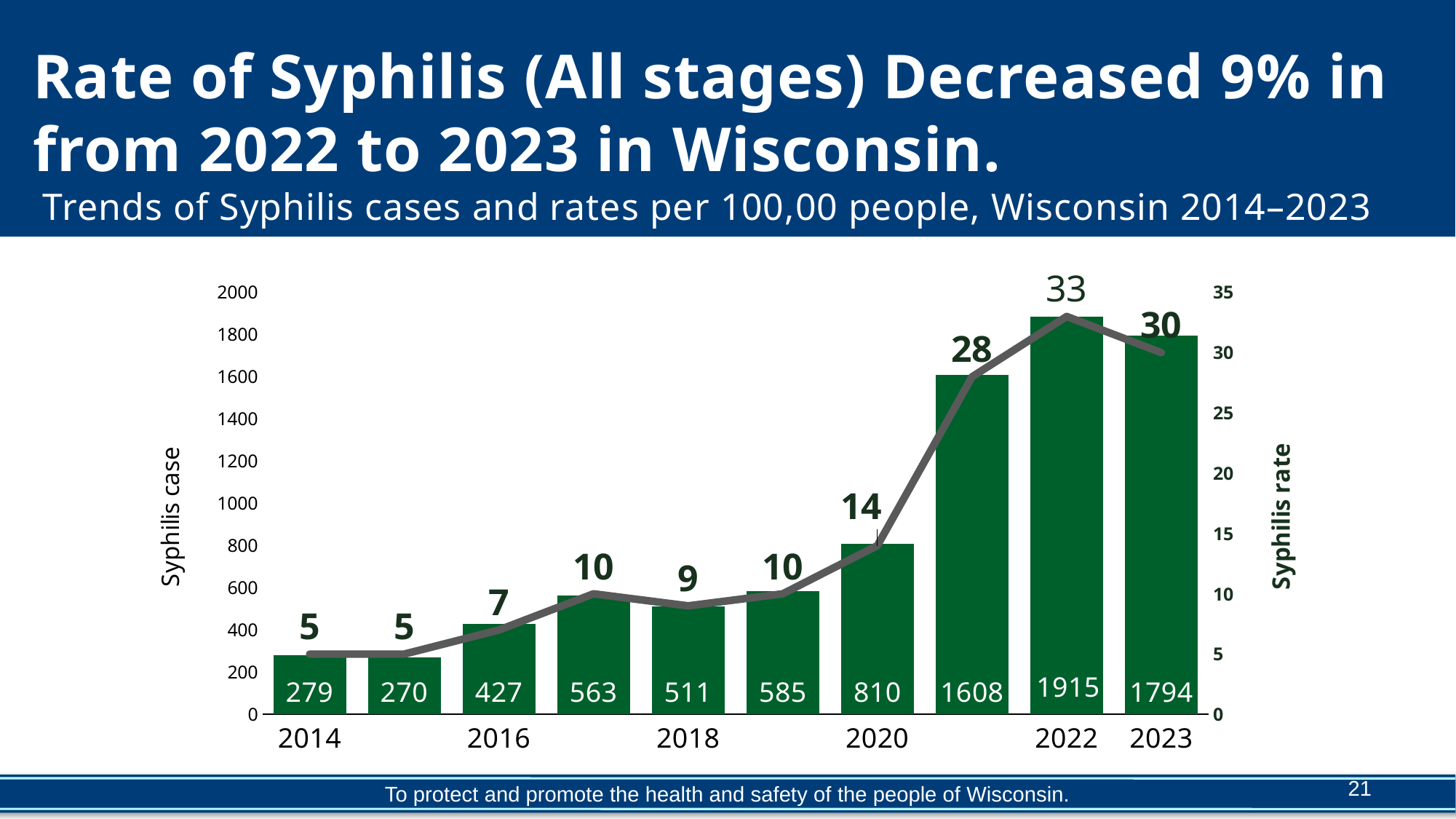
By how many cases did syphilis cases fall from 2022 to 2023? 121 How many syphilis cases are shown for 2014? 279 What is the difference between the syphilis rate in 2022 and in 2023? 3 Which year has the highest syphilis rate? 2022 Do syphilis cases generally rise or fall from 2014 to 2022? Rise What is the syphilis rate shown for 2023? 30 How many bars (years) are plotted in the chart? 10 What kind of chart is shown on the slide? Bar chart with a line overlay Which year has the highest number of syphilis cases? 2022 How many syphilis cases are shown for 2022? 1915 Which year had more syphilis cases, 2016 or 2018? 2018 What is the syphilis rate shown for 2020? 14